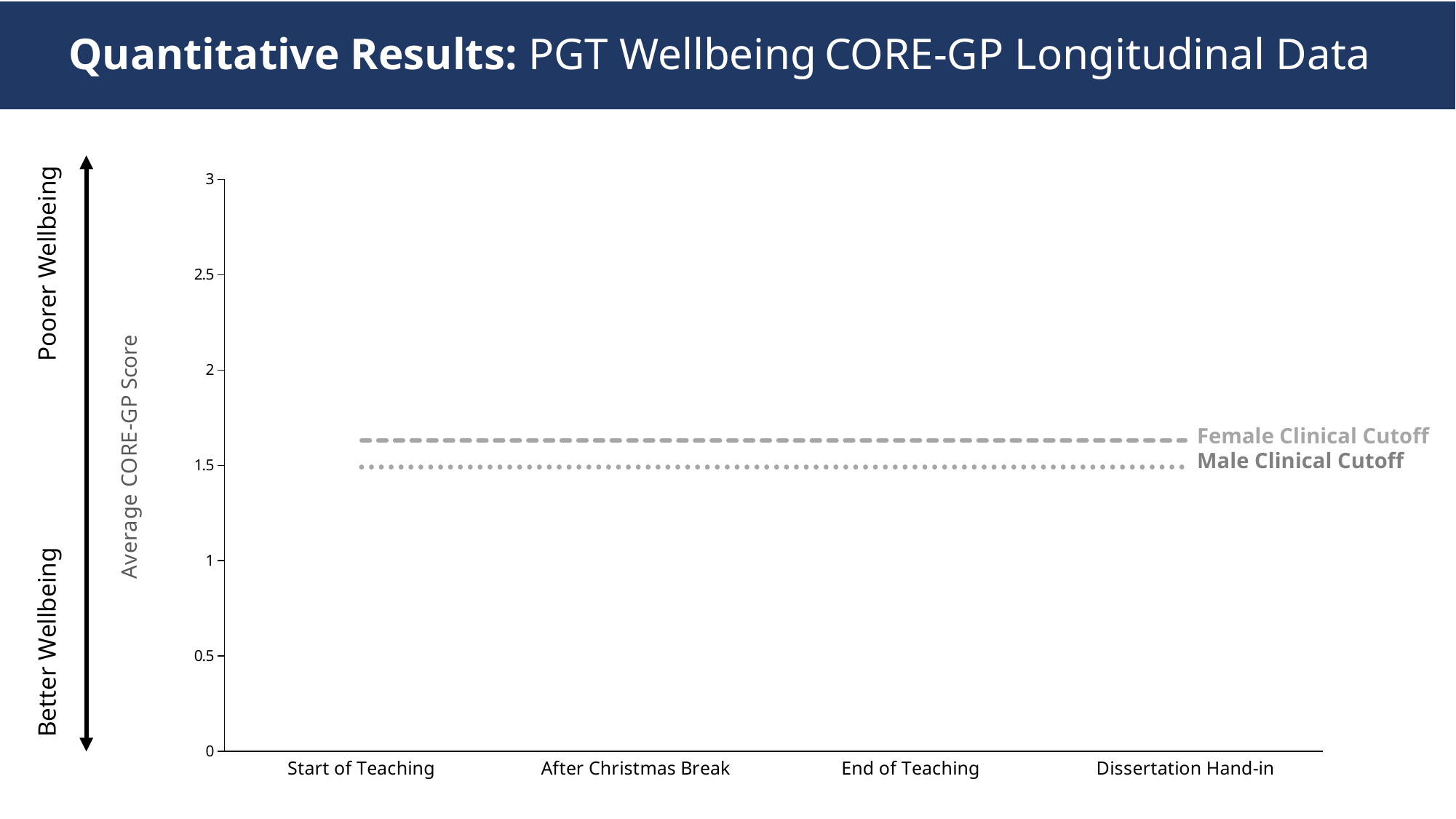
What is the label of the first category on the x axis? Start of Teaching Is the Female Clinical Cutoff line greater or less than 1.5 on the y axis? greater Which reference line is higher on the chart, the Female Clinical Cutoff or the Male Clinical Cutoff? Female Clinical Cutoff What is the label of the last category on the x axis? Dissertation Hand-in Is the Male Clinical Cutoff line greater or less than 1 on the y axis? greater Is the Female Clinical Cutoff line greater or less than 2 on the y axis? less What is the highest value shown on the y axis of the chart? 3 How many time points are labelled along the x axis of the chart? 4